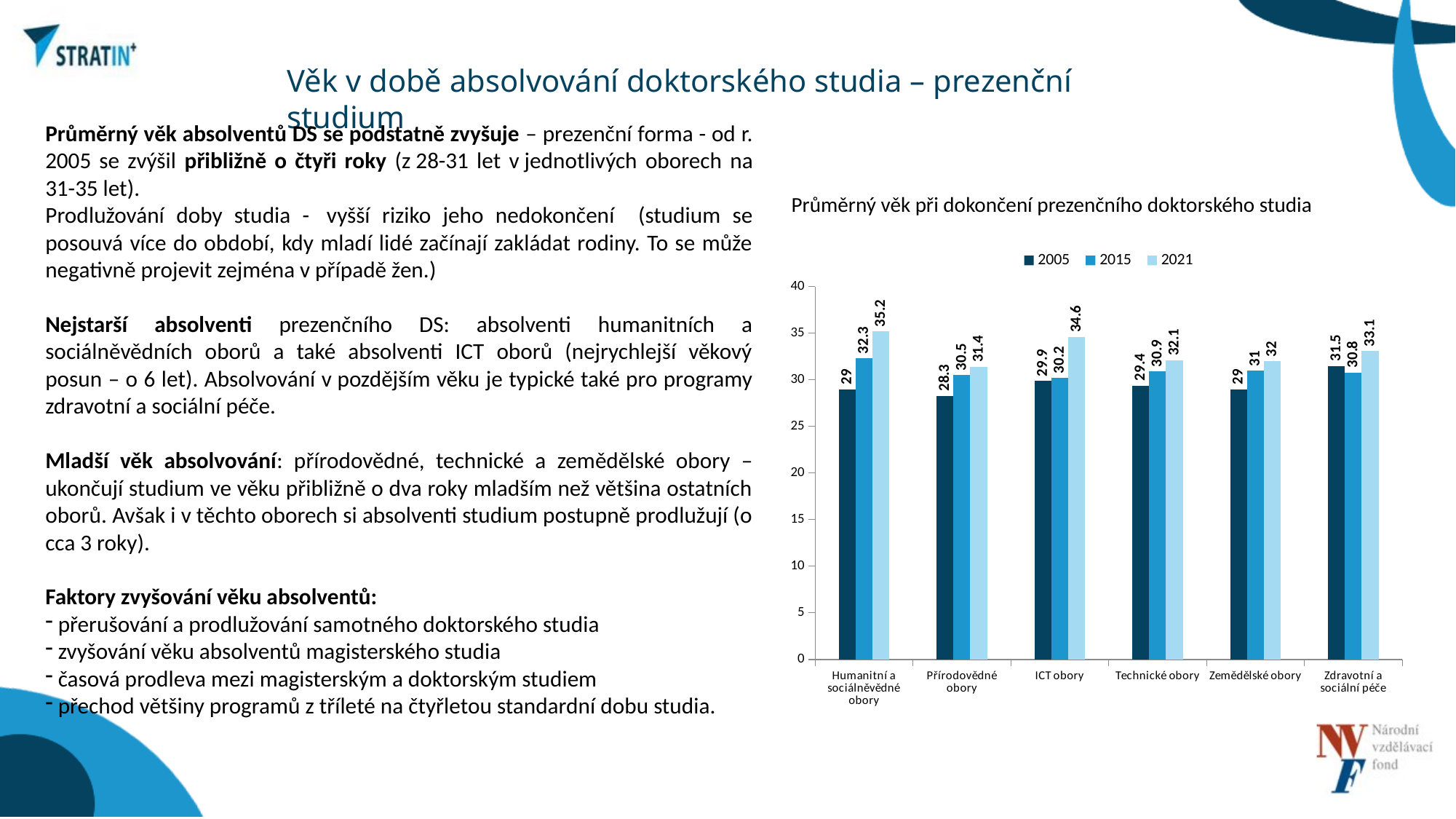
What is the 2015 value for ICT obory? 30.2 Which category has the lowest 2005 value? Přírodovědné obory What is the title of the chart? Průměrný věk při dokončení prezenčního doktorského studia How many categories (fields of study) are shown on the x axis of the chart? 6 What type of chart is shown on the slide? bar chart What is the 2021 value for Humanitní a sociálněvědné obory? 35.2 Which is larger for Zdravotní a sociální péče: the 2005 value or the 2015 value? 2005 Is the 2021 value for Přírodovědné obory greater or less than 30? greater Which category has the highest 2021 value? Humanitní a sociálněvědné obory What is the 2005 value for Zdravotní a sociální péče? 31.5 How many series does the chart legend list? 3 What is the difference between the 2021 and 2005 values for ICT obory? 4.7